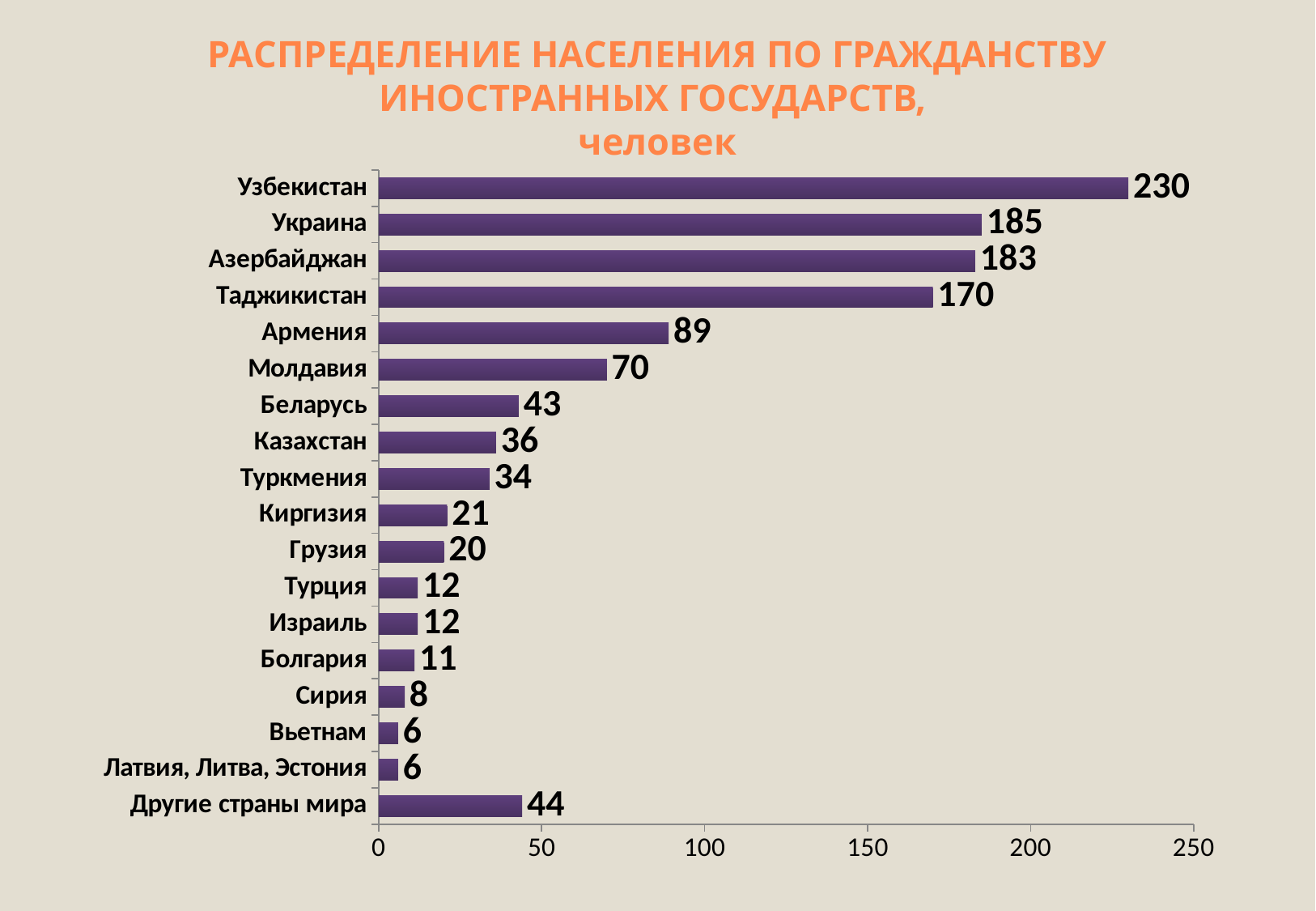
What is the value for Армения? 89 Which is larger, the value for Сирия or the value for Болгария? Болгария What is the value for Узбекистан? 230 What is the unit given in the chart title? человек Which country has the highest value? Узбекистан What is the value for Туркмения? 34 What is the value for Другие страны мира? 44 What is the difference between the values for Таджикистан and Молдавия? 100 What is the difference between the values for Украина and Азербайджан? 2 How many categories are shown on the chart? 18 What kind of chart is shown on the slide? Bar chart Which is larger, the value for Беларусь or the value for Казахстан? Беларусь